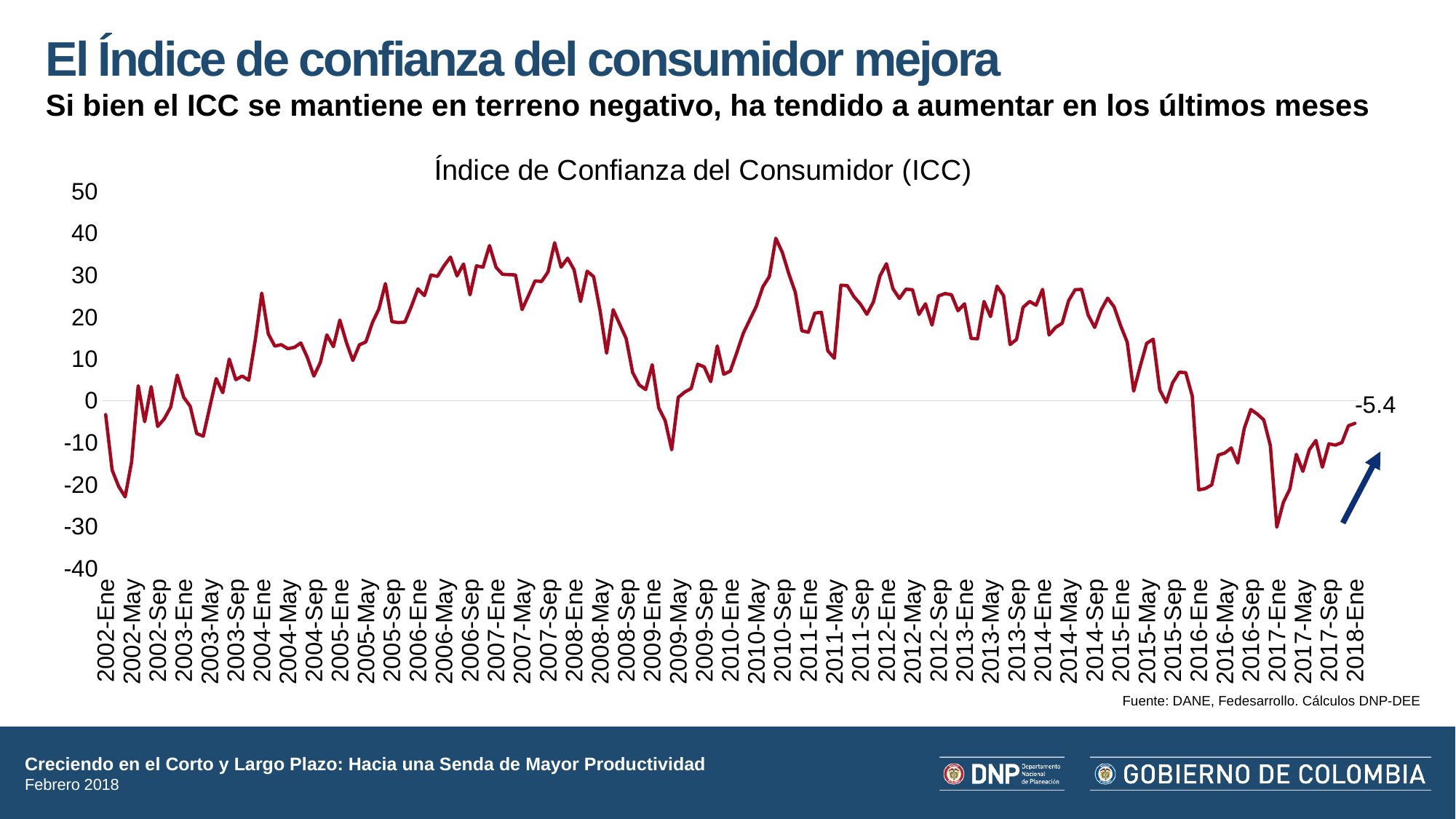
What are the lowest and highest values shown on the chart's vertical axis? -40 and 50 How many lines are plotted on the chart? 1 What is the title of the chart? Índice de Confianza del Consumidor (ICC) Around which x-axis label does the ICC line reach its lowest point? 2017-Ene Which is larger, the ICC value for 2017-Ene or for 2018-Ene? 2018-Ene What is the value of the ICC for 2018-Ene, as labelled on the chart? -5.4 What kind of chart is used to show the Índice de Confianza del Consumidor? line chart Is the ICC value for 2016-Ene greater or less than -10? less Is the ICC value for 2017-Ene greater or less than -20? less Does the ICC line rise or fall between 2017-Ene and 2018-Ene? rise Is the ICC value for 2010-Sep greater or less than 30? greater